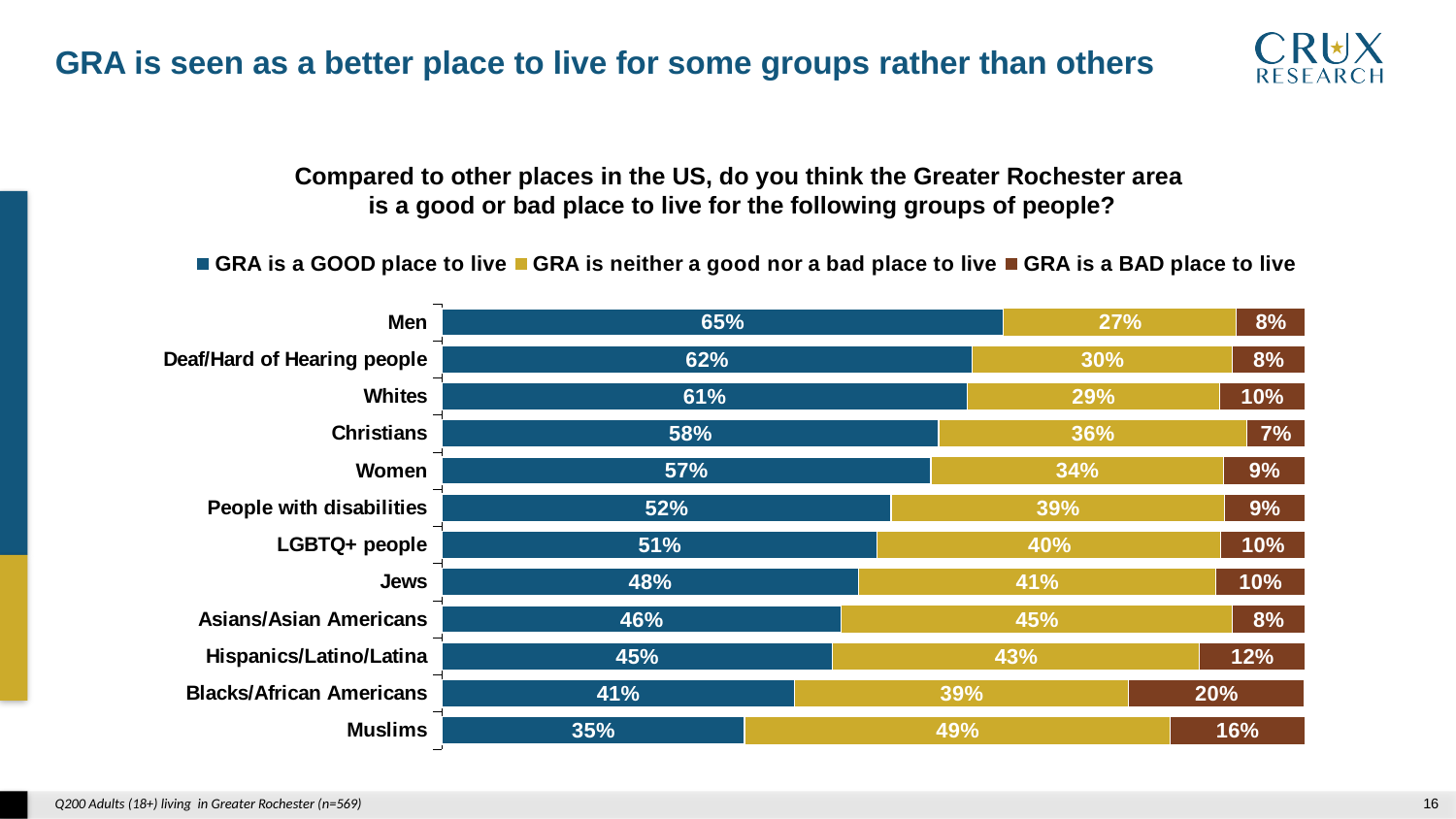
What is the total of the three segments for the Hispanics/Latino/Latina bar? 100% How many groups are shown in the chart? 12 Which is larger: the GOOD percentage for Whites or the GOOD percentage for Christians? Whites How many series does the legend list? 3 Which group has the highest percentage saying GRA is a BAD place to live? Blacks/African Americans What kind of chart is shown on the slide? Stacked bar chart Which group has the highest percentage saying GRA is a GOOD place to live? Men What is the difference between the GOOD percentage for Men and the GOOD percentage for Muslims? 30% What percentage say GRA is neither a good nor a bad place to live for Muslims? 49% Which group has the lowest percentage saying GRA is a GOOD place to live? Muslims What percentage say GRA is a BAD place to live for Blacks/African Americans? 20% What percentage say GRA is a GOOD place to live for Men? 65%